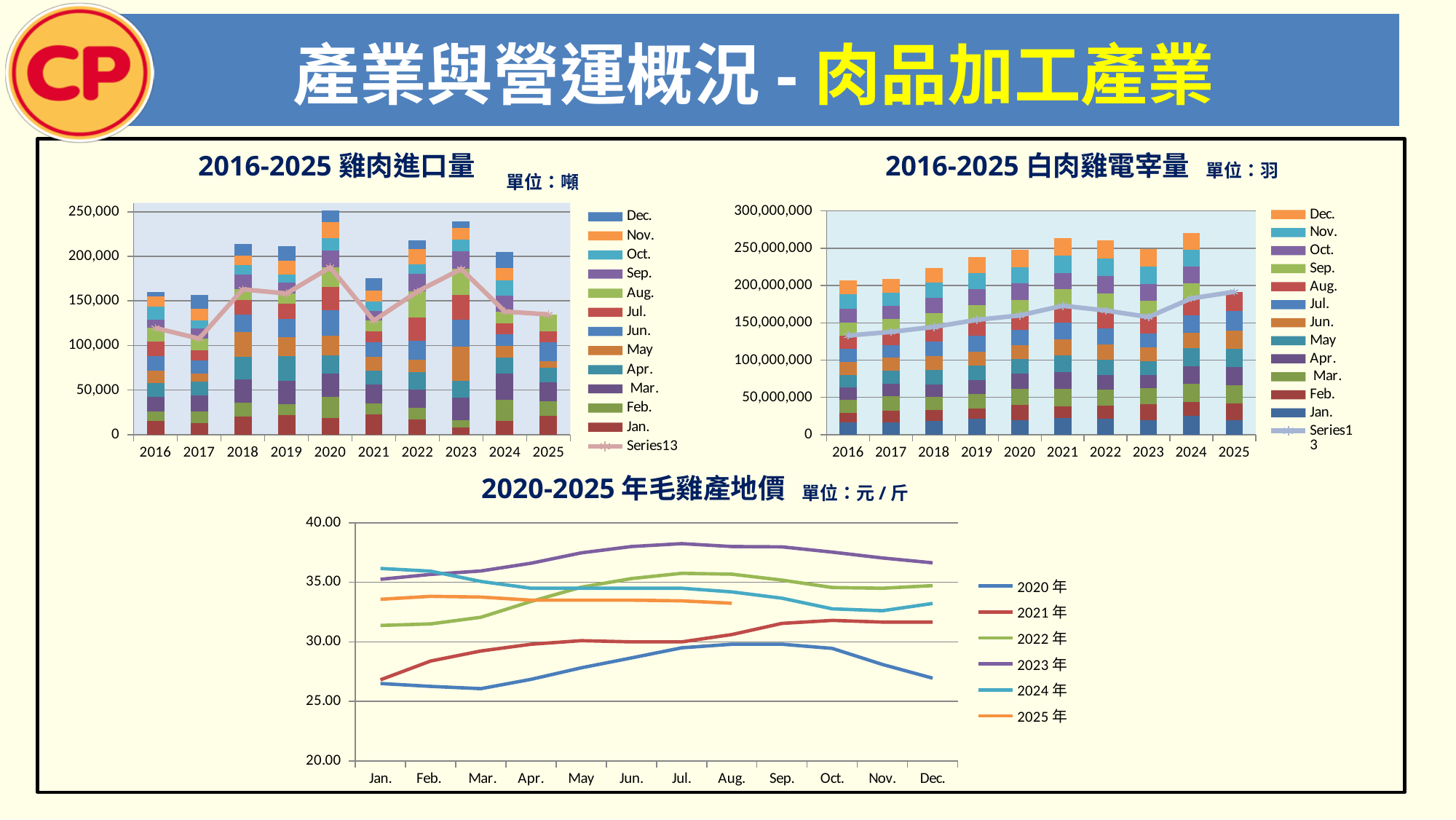
In the chart titled 2016-2025 雞肉進口量, which year has the shortest stacked bar? 2025 In the chart titled 2016-2025 雞肉進口量, is the total for 2021 greater or less than 200,000? less In the chart titled 2020-2025 年毛雞產地價, is the value for 2023 年 in Jul. greater or less than 35.00? greater In the chart titled 2016-2025 雞肉進口量, how many entries does the legend list? 13 What kind of chart is the one titled 2020-2025 年毛雞產地價? line chart In the chart titled 2016-2025 雞肉進口量, which year has the tallest stacked bar? 2020 In the chart titled 2016-2025 白肉雞電宰量, is the total for 2024 greater or less than 250,000,000? greater In the chart titled 2020-2025 年毛雞產地價, how many series does the legend list? 6 In the chart titled 2016-2025 雞肉進口量, how many years are shown on the x axis? 10 In the chart titled 2016-2025 白肉雞電宰量, what unit is stated next to the title? 羽